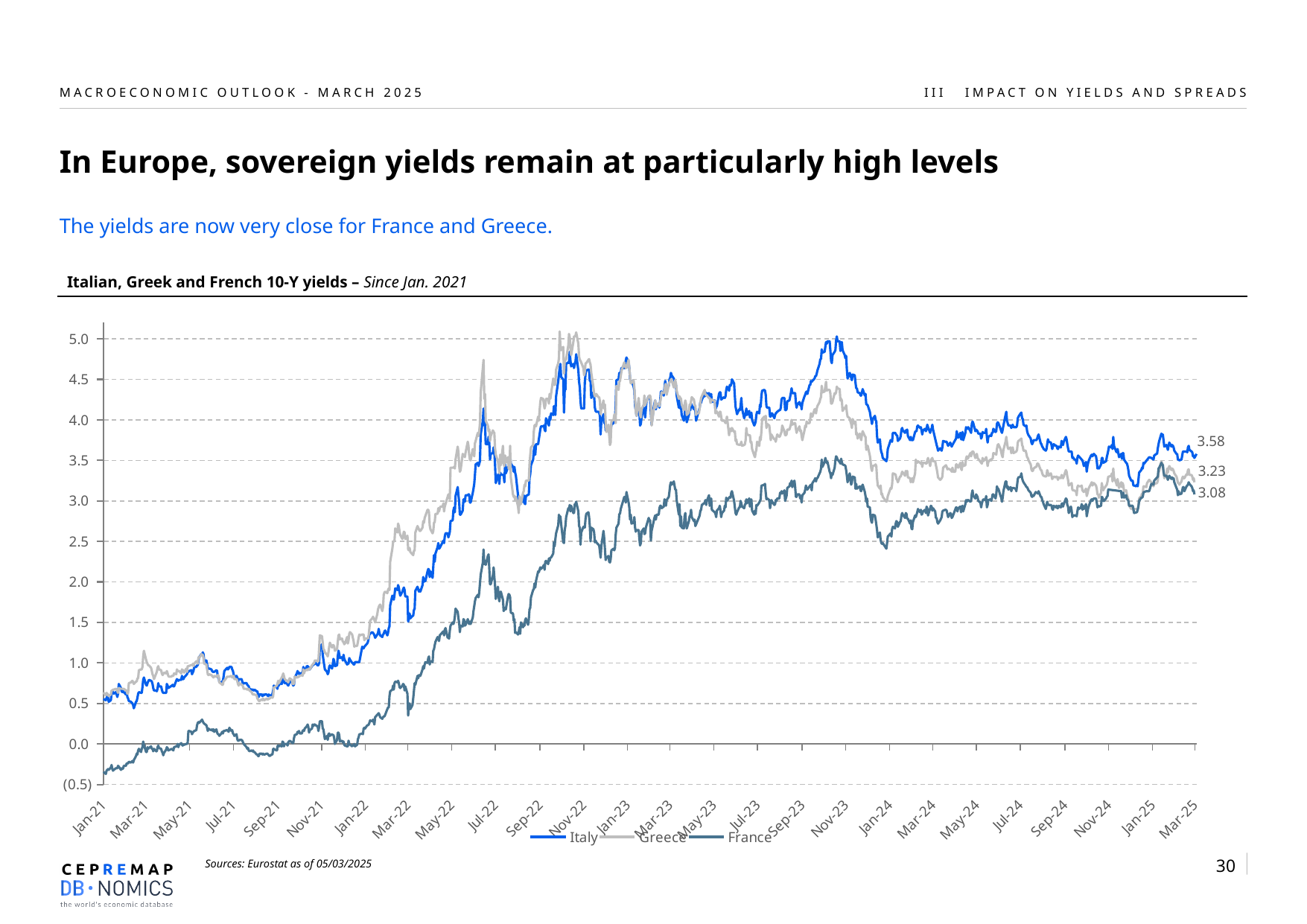
How many series does the legend list? 3 Is the value for France in Jan-21 greater or less than 0.0? less Is the peak value for Italy around Nov-23 greater or less than 4.5? greater Which country has the highest 10-Y yield at the end of the series (Mar-25)? Italy What is the latest value shown for Italy at the right end of the chart? 3.58 What is the difference between the latest Greek and French yields shown on the chart? 0.15 What is the difference between the latest Italian and French yields shown on the chart? 0.50 What is the latest value shown for France at the right end of the chart? 3.08 At the end of the series, is the yield for Greece or for France larger? Greece Which country has the lowest 10-Y yield at the end of the series (Mar-25)? France What kind of chart is shown on the slide? Line chart What is the latest value shown for Greece at the right end of the chart? 3.23